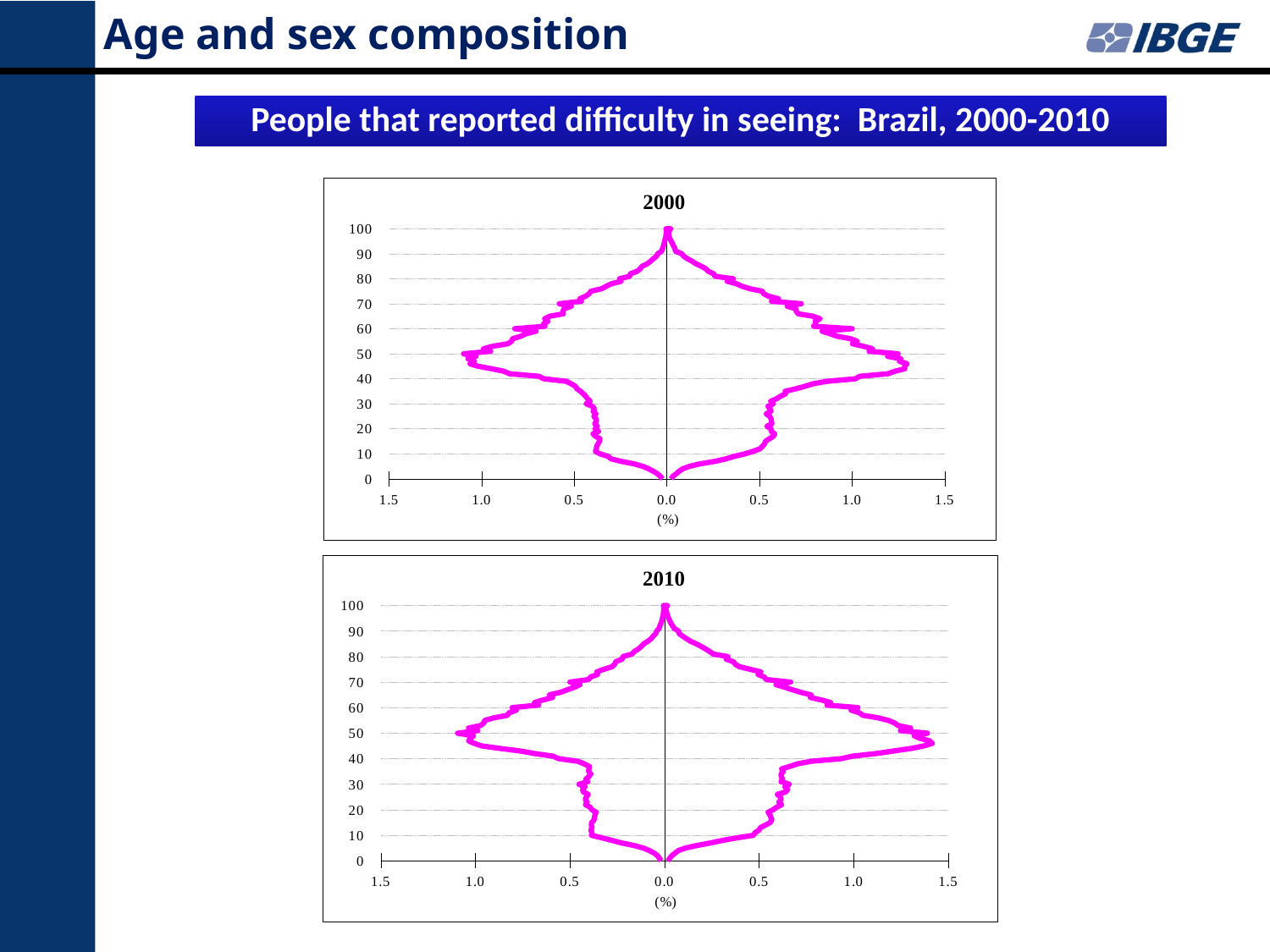
In the 2000 chart, is the value on the right side at age 50 greater or less than 1.0? greater In the 2010 chart, is the value on the right side at age 50 greater or less than 1.0? greater How many charts are shown on the slide? 2 In the 2000 chart, is the value on the right side at age 80 greater or less than 0.5? less What unit is shown on the x axis of the 2000 chart? (%) In the 2000 chart, at age 50, which side of the pyramid extends further from the centre, the left or the right? right In the 2000 chart, what is the largest value labelled on the x axis? 1.5 In the 2010 chart, do the values rise or fall as age increases from 50 to 100? fall What is the title of the bottom chart? 2010 What kind of chart is the top chart titled 2000? line chart In the 2010 chart, what is the highest age labelled on the y axis? 100